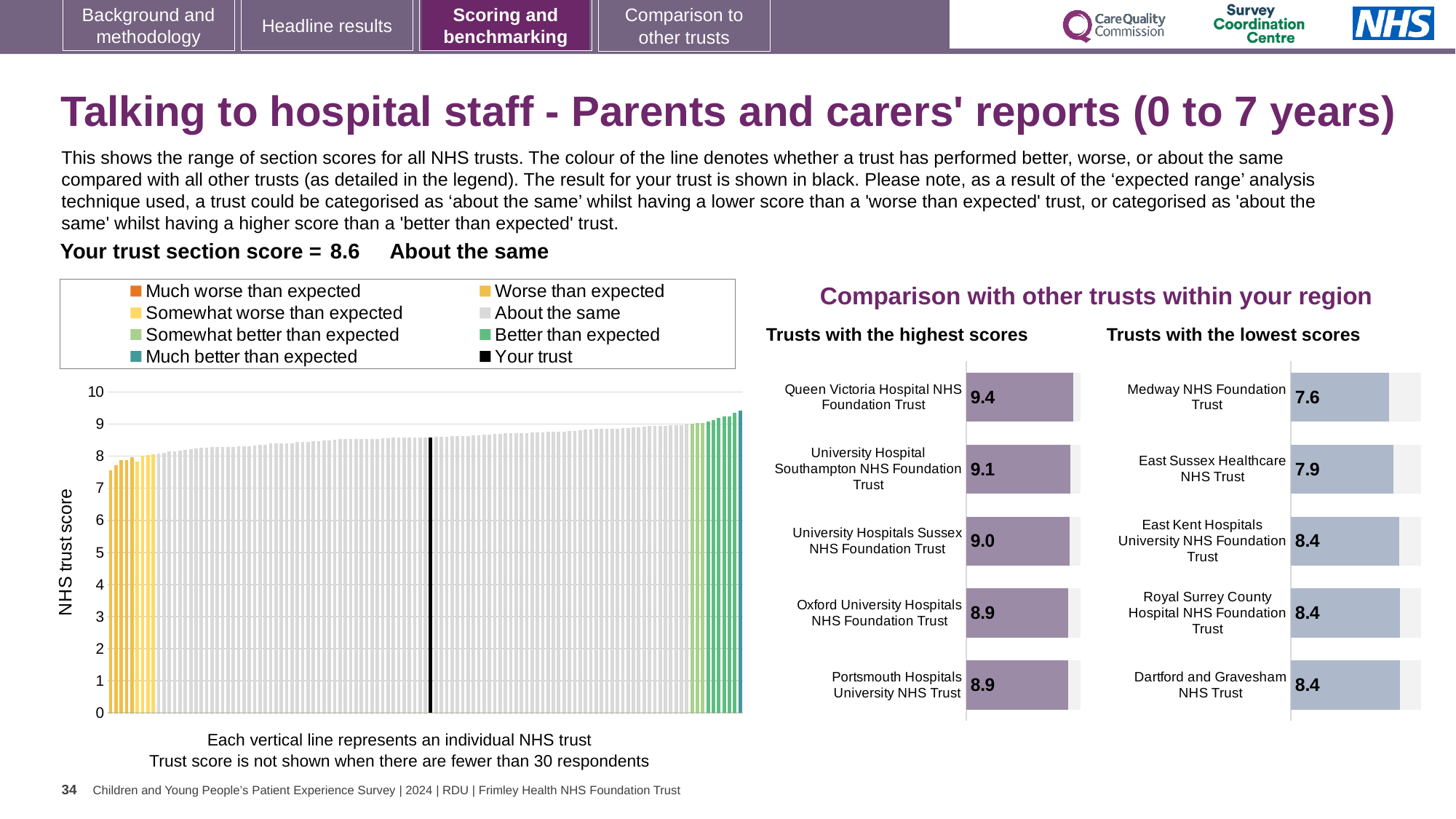
In the left chart of NHS trust scores, is the value for the black 'Your trust' line greater or less than 8? greater How many entries does the legend of the left NHS trust score chart list? 8 In the 'Trusts with the highest scores' chart, what is the score for Queen Victoria Hospital NHS Foundation Trust? 9.4 In the 'Trusts with the lowest scores' chart, what is the difference between the scores of East Sussex Healthcare NHS Trust and Medway NHS Foundation Trust? 0.3 In the 'Trusts with the highest scores' chart, what is the score for University Hospitals Sussex NHS Foundation Trust? 9.0 In the 'Trusts with the lowest scores' chart, which has the higher score: Medway NHS Foundation Trust or East Kent Hospitals University NHS Foundation Trust? East Kent Hospitals University NHS Foundation Trust In the 'Trusts with the highest scores' chart, which trust has the highest score? Queen Victoria Hospital NHS Foundation Trust What kind of chart is the 'Trusts with the lowest scores' chart? bar chart In the 'Trusts with the highest scores' chart, what is the difference between the scores of Queen Victoria Hospital NHS Foundation Trust and Portsmouth Hospitals University NHS Trust? 0.5 In the 'Trusts with the lowest scores' chart, which trust has the lowest score? Medway NHS Foundation Trust How many trusts are listed in the 'Trusts with the highest scores' chart? 5 In the 'Trusts with the lowest scores' chart, what is the score for Medway NHS Foundation Trust? 7.6